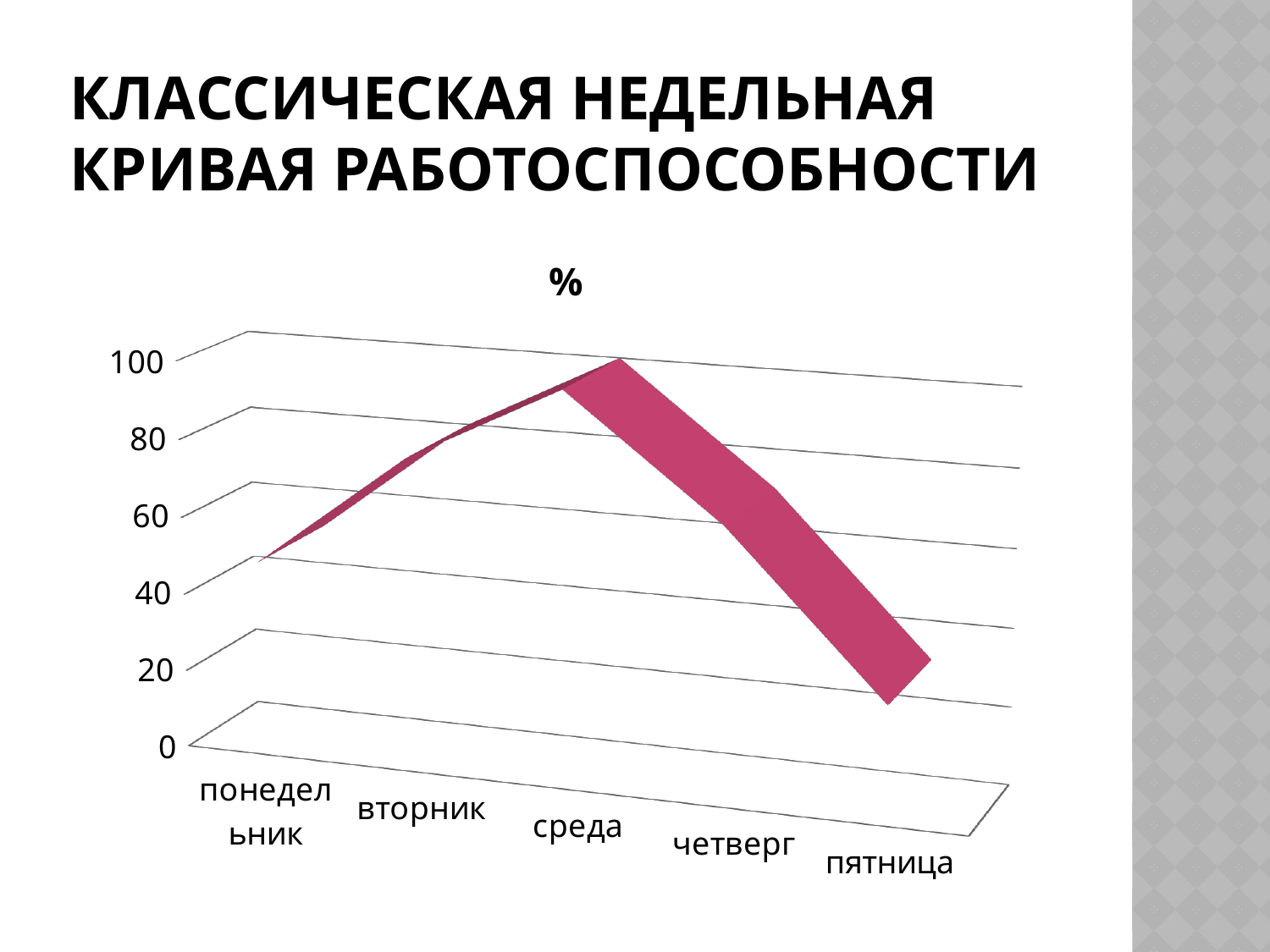
Is the value for понедельник greater or less than 20? greater Which is larger, the value for среда or the value for пятница? среда Is the value for среда greater or less than 60? greater How do the values change from понедельник to пятница? rise to a peak on среда, then fall Which day has the lowest value on the chart? пятница Which is larger, the value for понедельник or the value for среда? среда What kind of chart is shown on the slide? line chart How many days (categories) are plotted along the x axis? 5 What is the title of the chart? % What is the highest value shown on the vertical axis? 100 Which day has the highest value on the chart? среда Is the value for пятница greater or less than 60? less